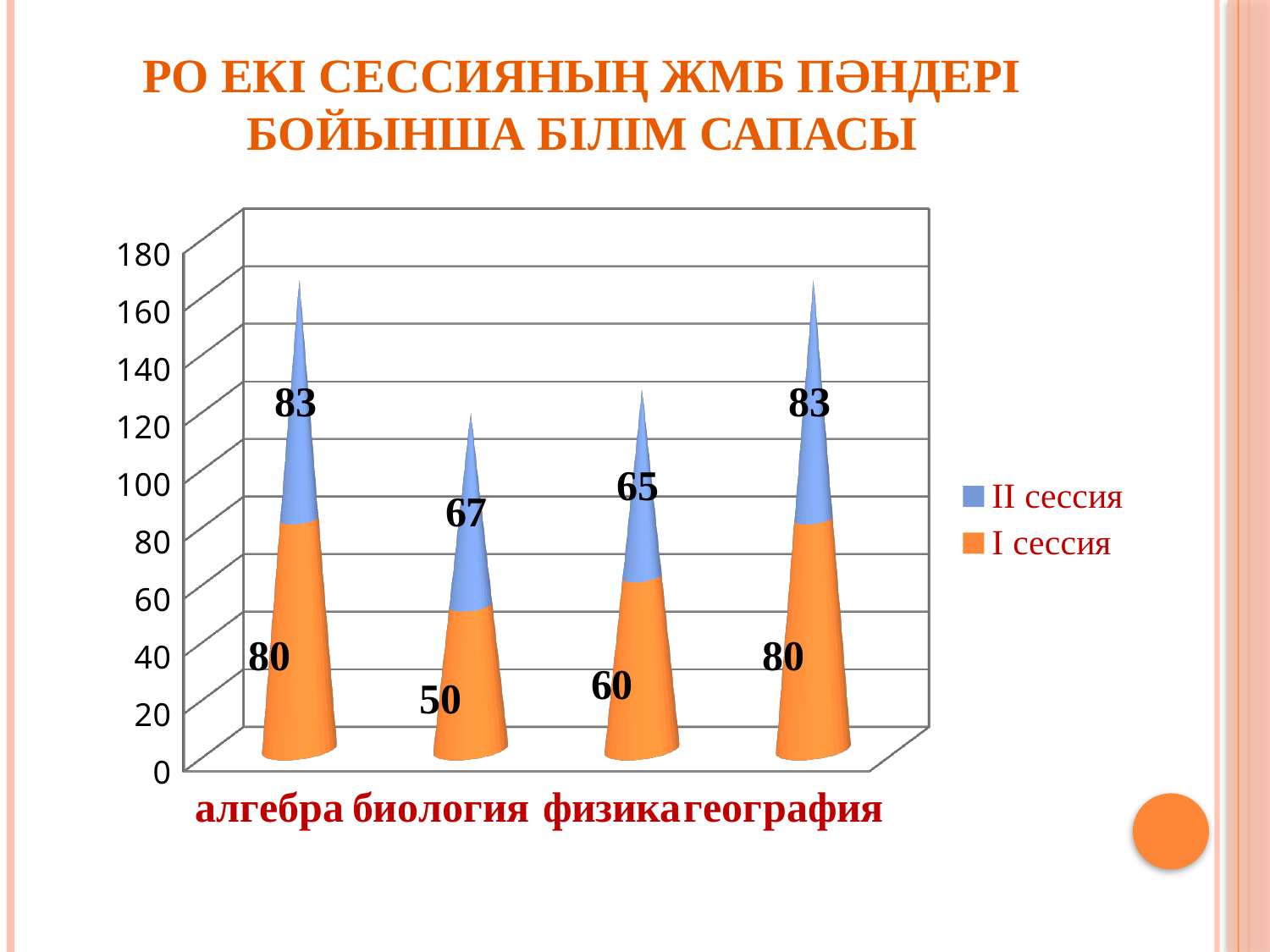
What is the value for II сессия for биология? 67 What is the total of the stacked bar for биология? 117 What is the value for I сессия for физика? 60 What is the value for II сессия for география? 83 What is the difference between the II сессия and I сессия values for биология? 17 Which is larger: the I сессия value for физика or the I сессия value for биология? физика What is the value for I сессия for алгебра? 80 How many categories are shown on the x axis? 4 What kind of chart is shown on the slide? stacked bar chart Which category has the lowest value for I сессия? биология Which category has the lowest value for II сессия? физика How many series does the legend list? 2